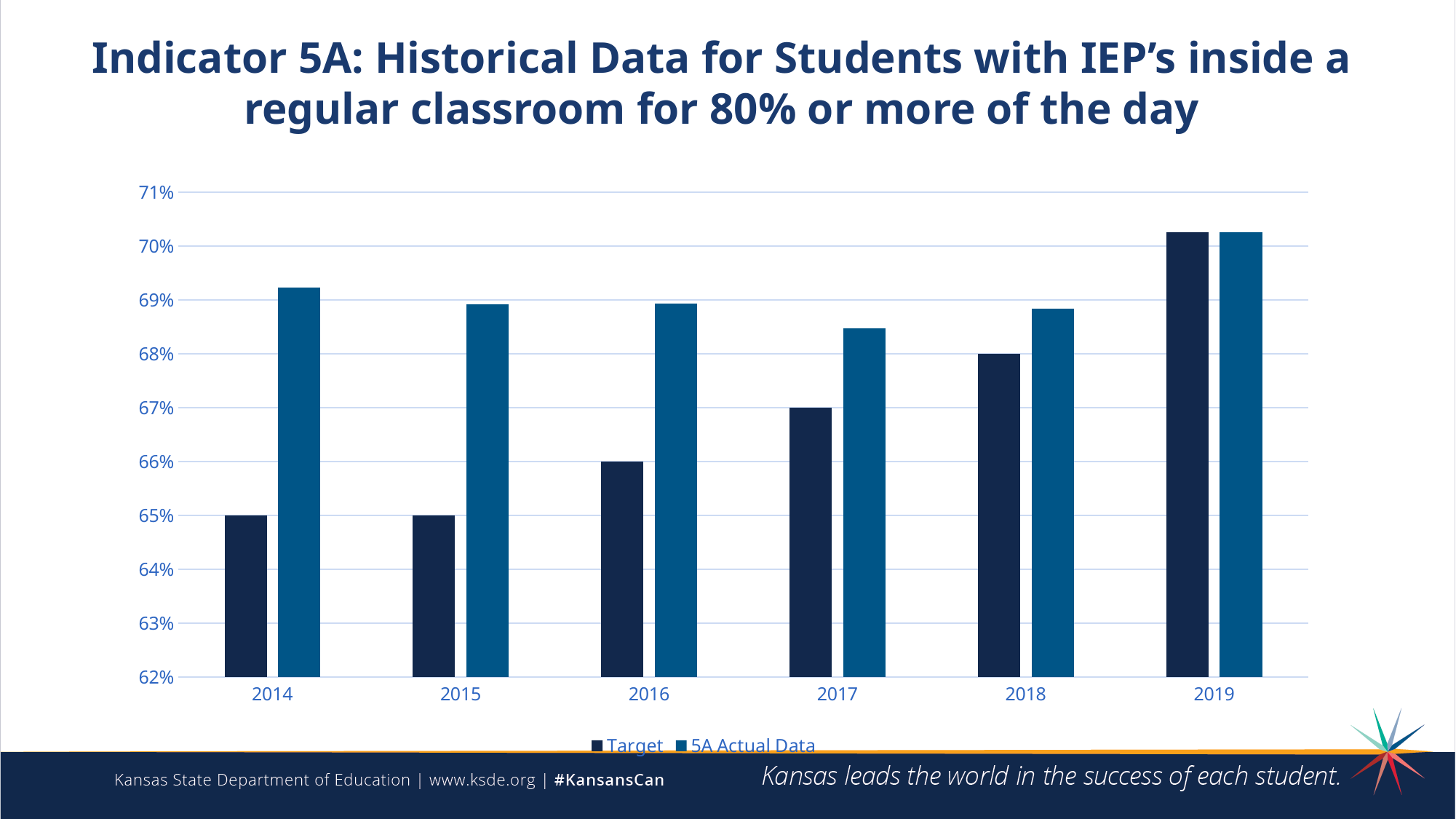
Is the 5A Actual Data value for 2017 greater or less than 69%? less Is the 5A Actual Data value for 2014 greater or less than 69%? greater What is the Target value for 2014? 65% What is the Target value for 2018? 68% How many series does the legend list? 2 What type of chart is shown on the slide? bar chart How many years are shown on the x axis? 6 In 2014, which is larger: the Target or the 5A Actual Data value? 5A Actual Data Which year has the lowest 5A Actual Data value? 2017 What is the Target value for 2017? 67% Which year has the highest 5A Actual Data value? 2019 What is the Target value for 2016? 66%